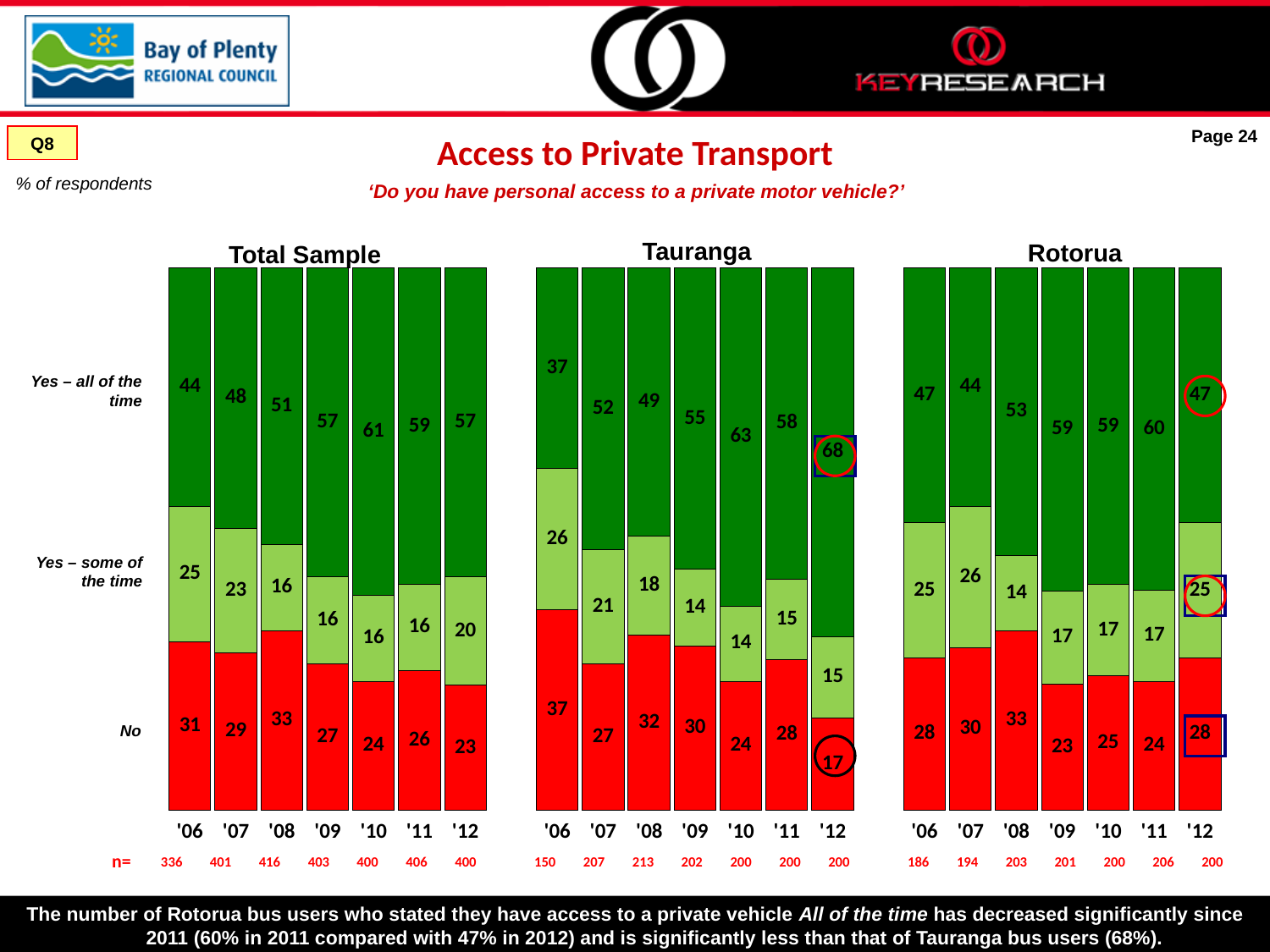
What kind of chart is the Total Sample chart? Stacked bar chart In the Total Sample chart, which year has the lowest 'No' value? '12 How many response categories are stacked in each bar of the Tauranga chart? 3 In the Total Sample chart, which year has the larger 'No' value, '08 or '12? '08 In the Rotorua chart, what percentage answered 'Yes – some of the time' in '07? 26 How many years are shown on the x axis of the Rotorua chart? 7 In the Tauranga chart, what percentage answered 'No' in '12? 17 In the Rotorua chart, what is the difference between the 'Yes – all of the time' values for '11 and '12? 13 In the Tauranga chart, what is the sample size (n=) for '06? 150 In the Total Sample chart, what percentage answered 'Yes – all of the time' in '10? 61 In the Total Sample chart, does the 'Yes – all of the time' value rise or fall from '06 to '10? Rise In the Tauranga chart, which year has the highest 'Yes – all of the time' value? '12